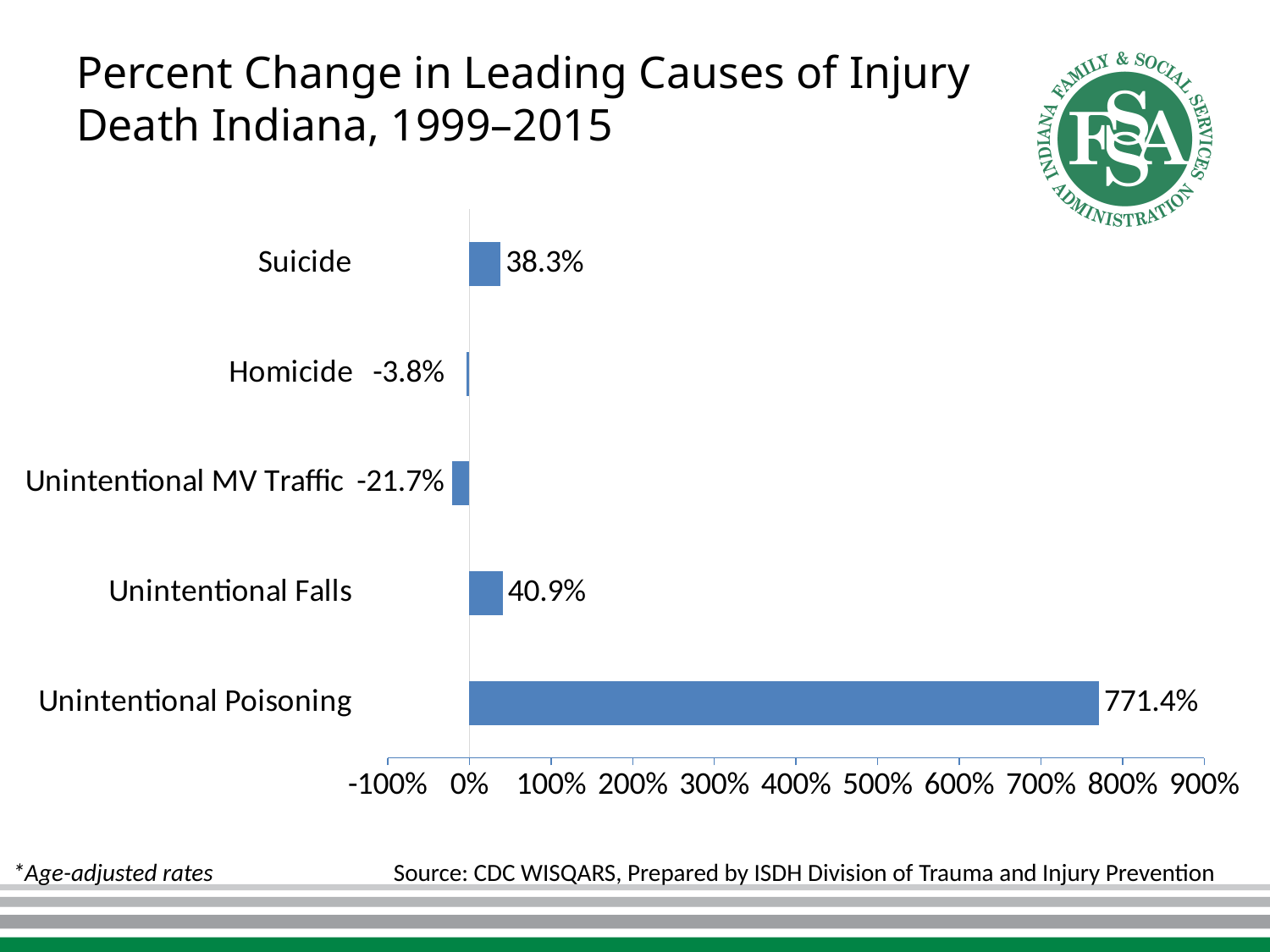
How many causes show a negative percent change? 2 What is the percent change for Unintentional Poisoning? 771.4% What kind of chart is shown on the slide? Bar chart How many causes of injury death are shown in the chart? 5 Which cause of injury death has the lowest percent change? Unintentional MV Traffic What is the percent change for Unintentional MV Traffic? -21.7% Which has a larger percent change, Unintentional Falls or Suicide? Unintentional Falls What is the percent change for Suicide? 38.3% What is the percent change for Homicide? -3.8% Which cause of injury death has the highest percent change? Unintentional Poisoning What is the percent change for Unintentional Falls? 40.9% What is the difference between the percent change for Unintentional Falls and Suicide? 2.6%